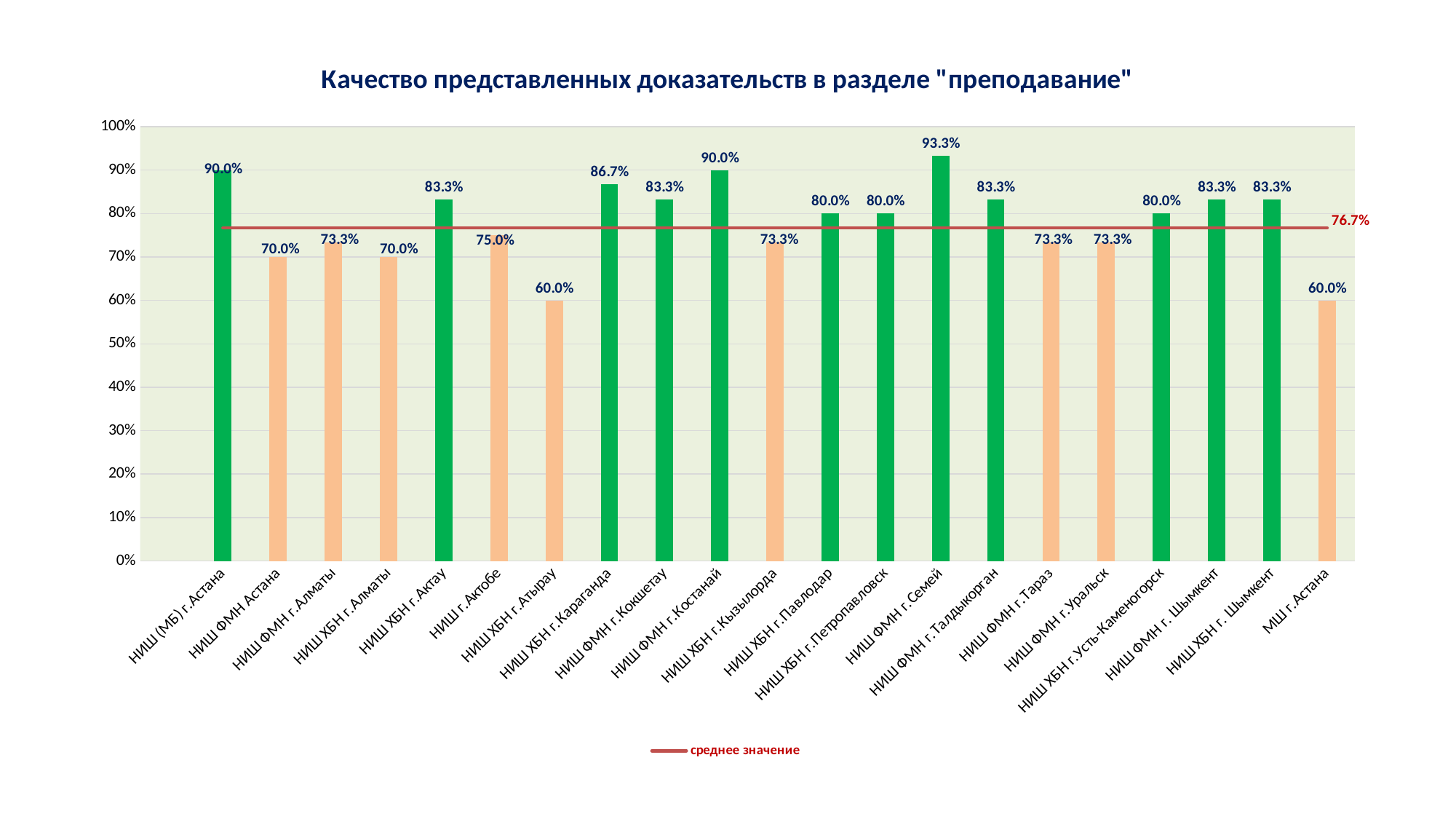
Which is larger, the value for НИШ ХБН г.Актау or the value for НИШ ХБН г.Павлодар? НИШ ХБН г.Актау What is the value for НИШ ФМН г.Семей? 93.3% Is the value for НИШ ХБН г.Атырау greater or less than 70%? less What is the value for НИШ ХБН г.Караганда? 86.7% What value is shown for the red average line (среднее значение)? 76.7% How many categories are shown on the x axis? 21 What is the difference between the values for НИШ ФМН г.Костанай and НИШ ФМН Астана? 20.0% What kind of chart is this? bar chart What is the value for НИШ г.Актобе? 75.0% Which category has the highest value? НИШ ФМН г.Семей What is the value for МШ г.Астана? 60.0% What is the lowest value shown on the chart? 60.0%